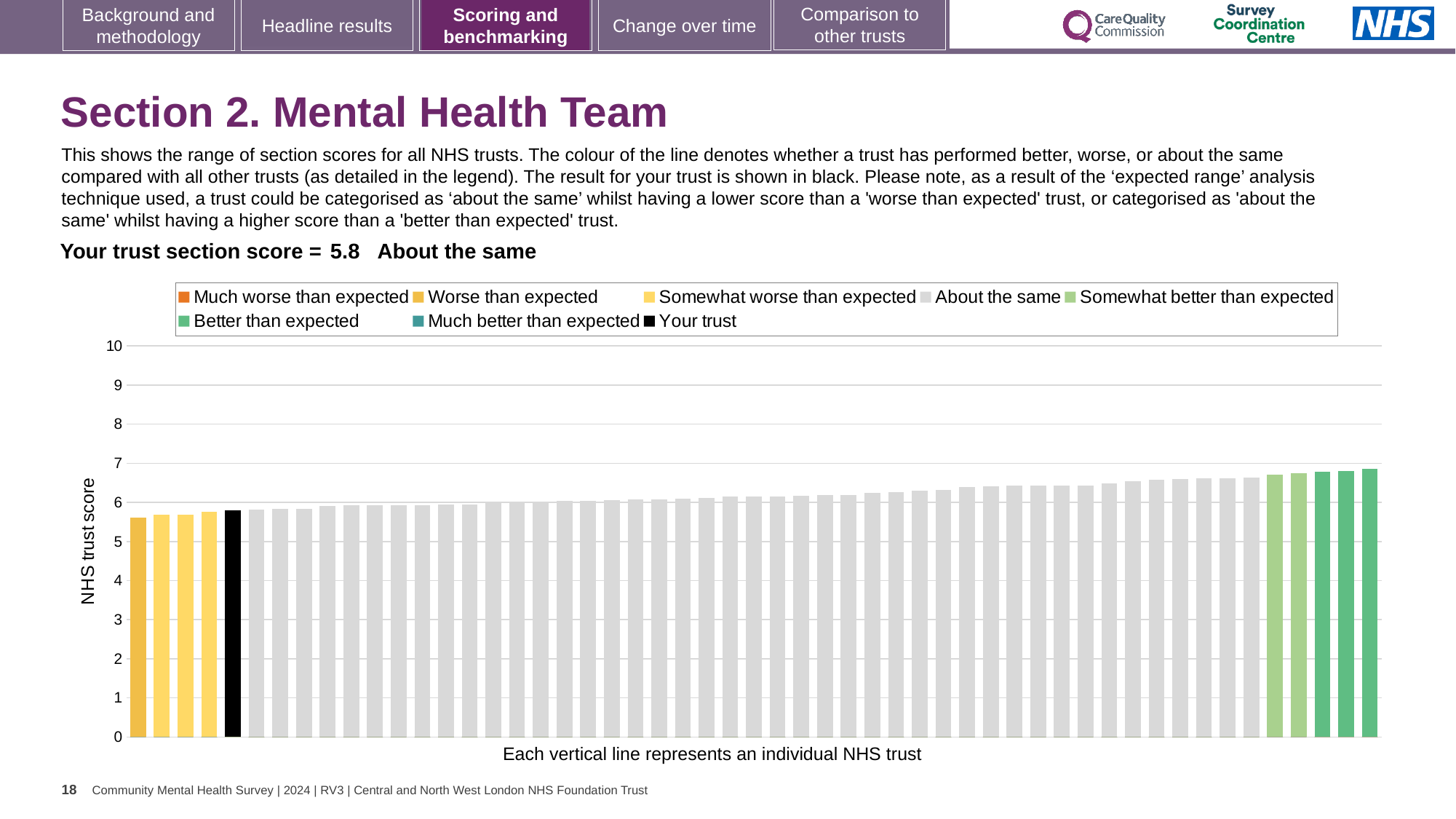
What is the label on the vertical axis of the chart? NHS trust score How many bars are coloured as 'Better than expected' (dark green)? 3 Which performance category is your trust placed in for this section? About the same Do the bar values rise or fall from left to right along the x axis? rise How many bars are coloured as 'Somewhat better than expected' (light green)? 2 What is the section score for your trust shown on the slide? 5.8 Is the value of the lowest bar in the chart greater or less than 5? greater Is the value of the black bar for your trust greater or less than 5? greater How many entries does the chart legend list? 8 Is the value of the highest bar in the chart greater or less than 7? less What colour is the bar representing your trust? black What kind of chart is shown on the slide? bar chart